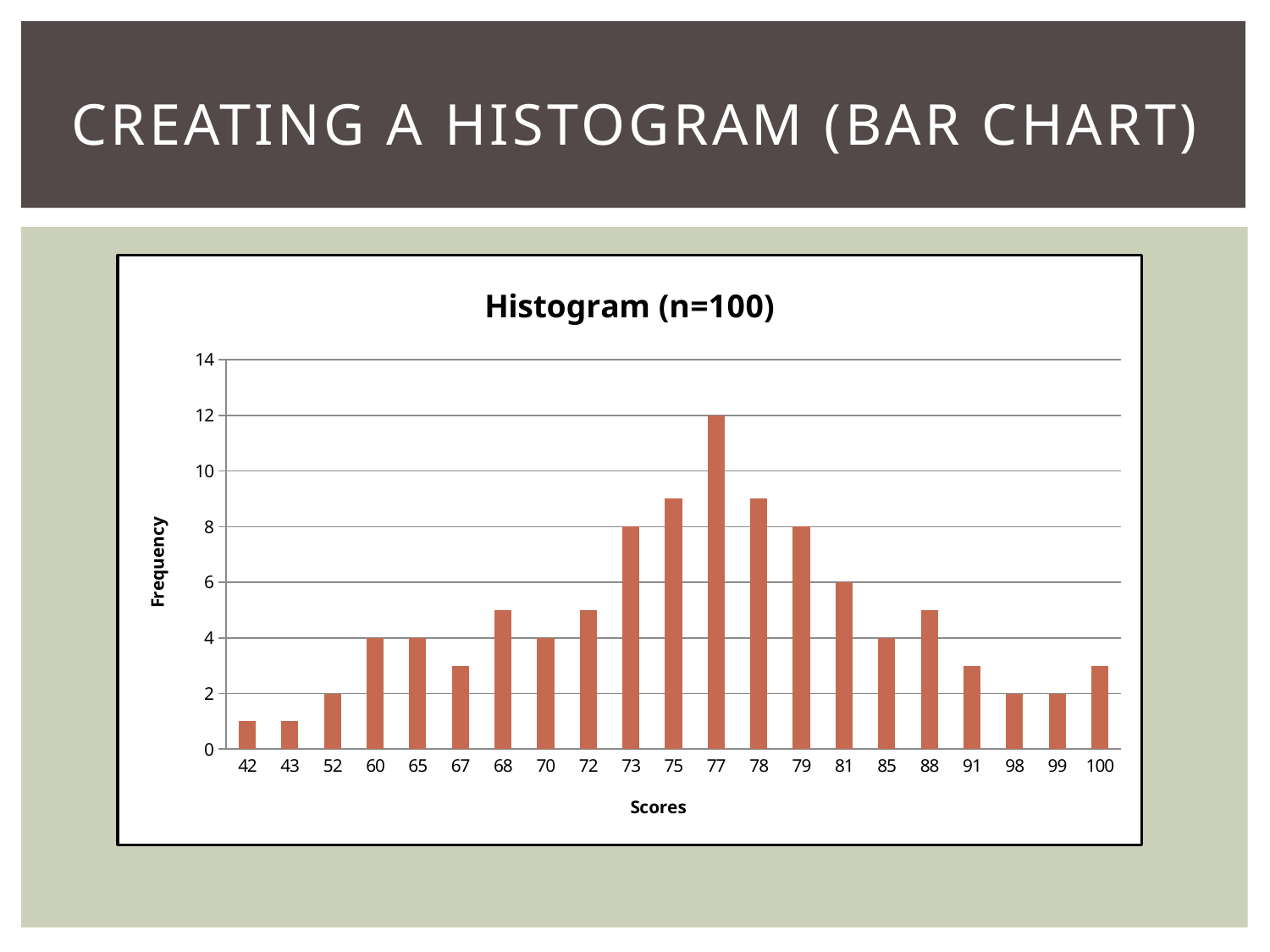
Is the frequency for score 42 greater or less than 2? less What is the title of the chart? Histogram (n=100) What is the frequency for score 52? 2 What is the frequency for score 73? 8 What is the frequency for score 81? 6 Is the frequency for score 75 greater or less than 8? greater What is the frequency for score 77? 12 What type of chart is shown on the slide? bar chart How many score categories are shown on the x axis? 21 Which score has the highest frequency? 77 Which has a higher frequency, score 77 or score 81? 77 What is the difference in frequency between score 77 and score 73? 4